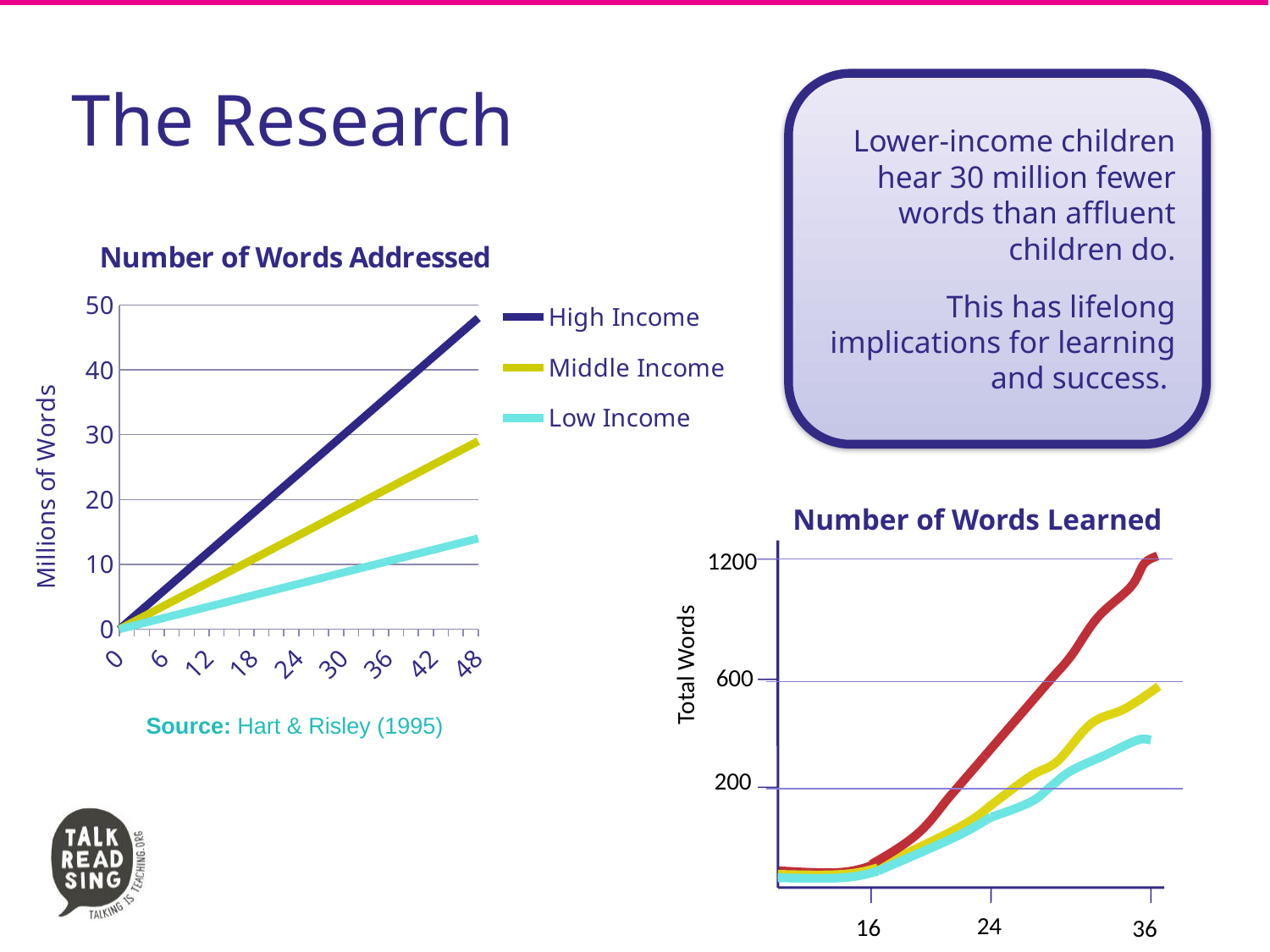
In the 'Number of Words Addressed' chart, which series has the highest value at 48 months? High Income How many series does the legend of the 'Number of Words Addressed' chart list? 3 In the 'Number of Words Learned' chart, is the value of the red line at 36 greater or less than 600? greater In the 'Number of Words Addressed' chart, is the High Income value at 48 months greater or less than 40? greater What source is cited below the 'Number of Words Addressed' chart? Hart & Risley (1995) In the 'Number of Words Addressed' chart, do the values rise or fall as the months increase along the x axis? rise What is the y-axis title of the 'Number of Words Addressed' chart? Millions of Words In the 'Number of Words Learned' chart, which line is lowest at 36: the red line or the light blue line? the light blue line What kind of chart is the 'Number of Words Addressed' chart? line chart In the 'Number of Words Addressed' chart, which series has the lowest value at 48 months? Low Income In the 'Number of Words Addressed' chart, is the Low Income value at 48 months greater or less than 20? less